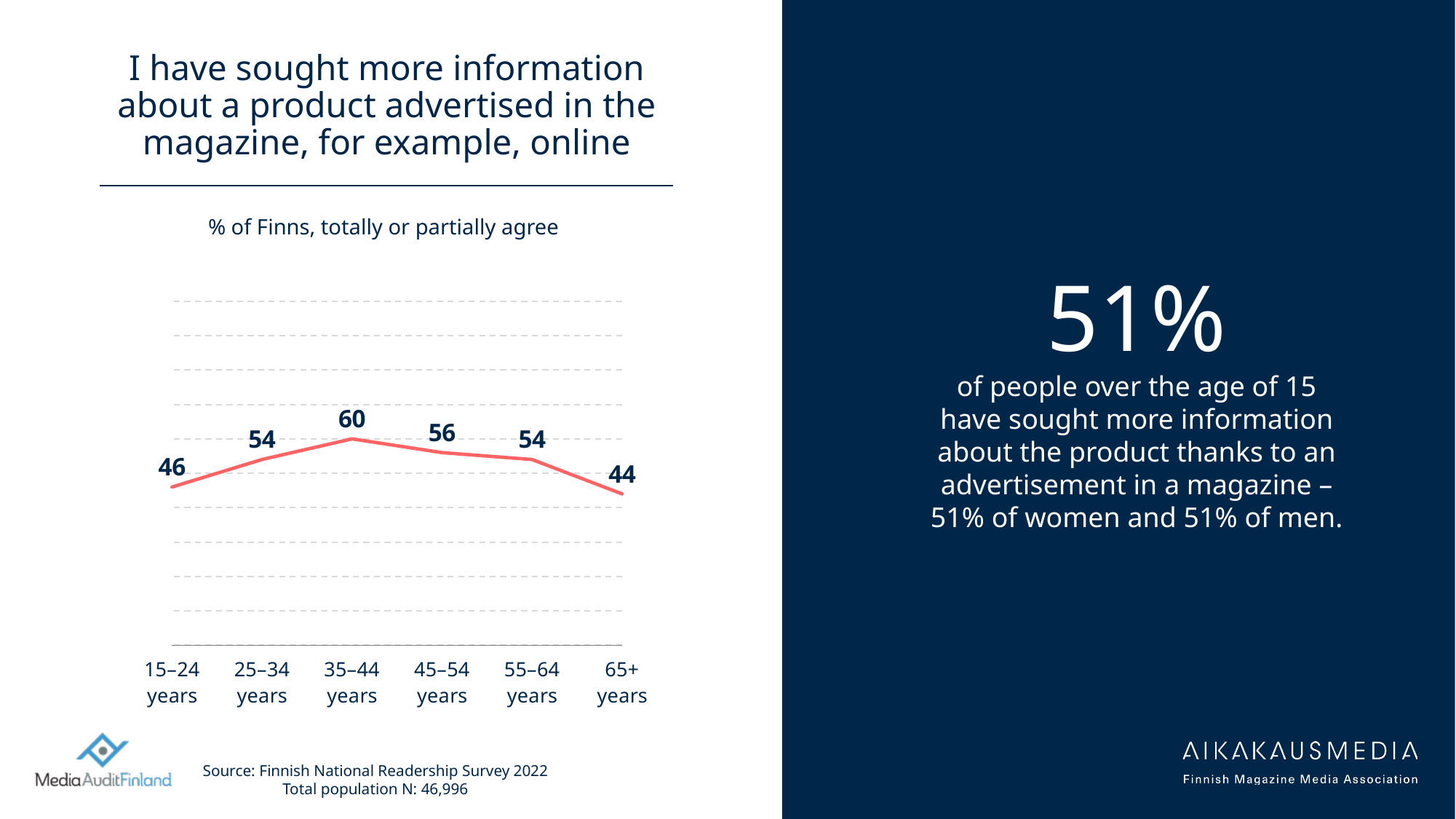
What is the difference between the values for 35–44 years and 65+ years? 16 What is the value for the 15–24 years age group? 46 Do the values rise or fall from 35–44 years to 65+ years? Fall Which age group has the lowest value? 65+ years What is the value for the 65+ years age group? 44 Which age group has the highest value? 35–44 years How many age groups are plotted on the chart? 6 Which is larger, the value for 45–54 years or the value for 55–64 years? 45–54 years What does the subtitle above the chart say the values represent? % of Finns, totally or partially agree What kind of chart is shown on the slide? Line chart What is the value for the 35–44 years age group? 60 What is the difference between the values for 25–34 years and 15–24 years? 8